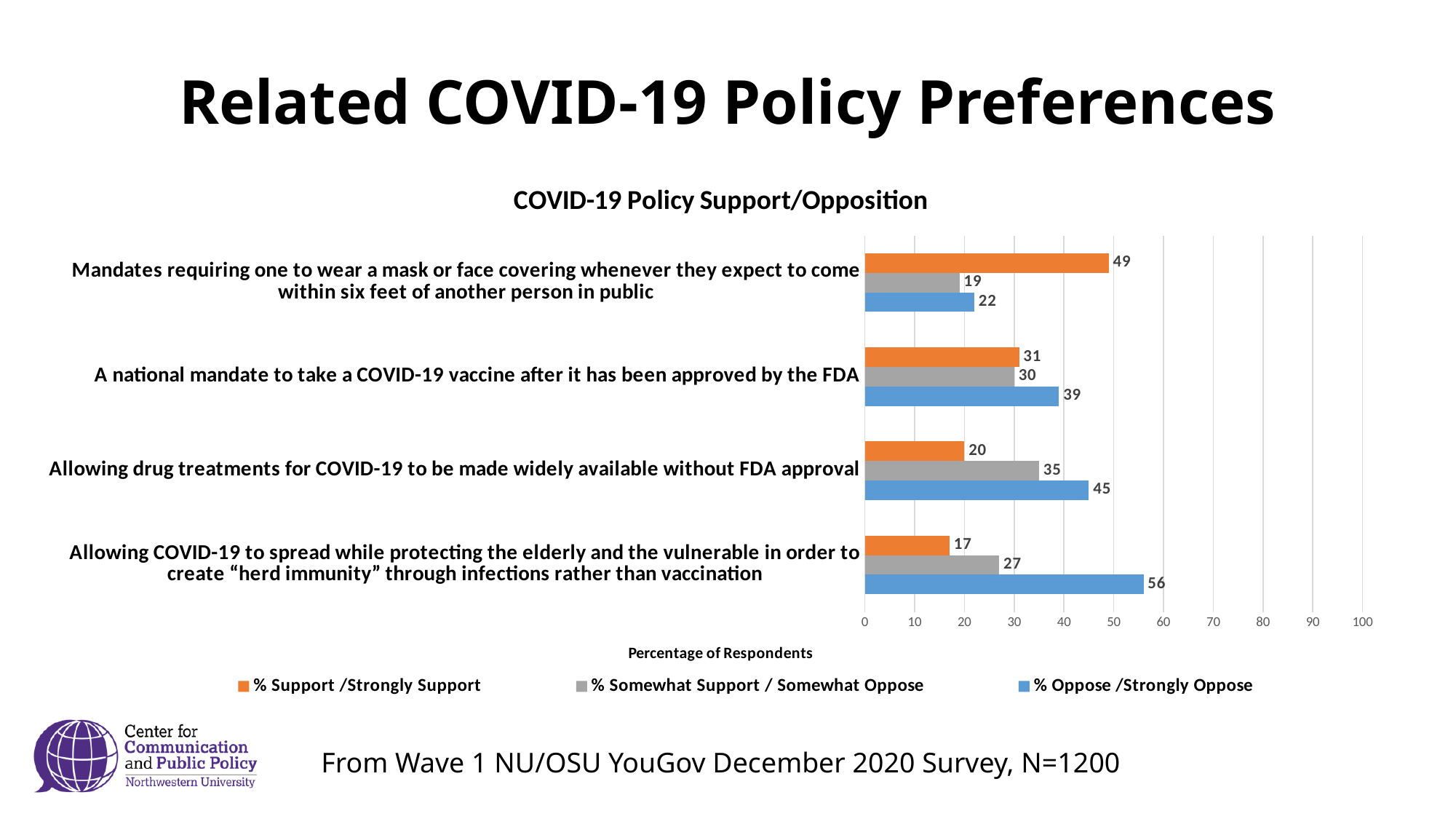
Which policy has the highest percentage of respondents who oppose or strongly oppose it? Allowing COVID-19 to spread while protecting the elderly and the vulnerable in order to create "herd immunity" through infections rather than vaccination What is the difference between the percentage who oppose/strongly oppose and the percentage who support/strongly support allowing COVID-19 to spread to create herd immunity? 39 What is the title of the chart? COVID-19 Policy Support/Opposition What percentage of respondents support or strongly support mandates requiring one to wear a mask or face covering whenever they expect to come within six feet of another person in public? 49 How many policies are shown on the chart? 4 What percentage of respondents somewhat support or somewhat oppose allowing drug treatments for COVID-19 to be made widely available without FDA approval? 35 Which policy has the lowest percentage of respondents who support or strongly support it? Allowing COVID-19 to spread while protecting the elderly and the vulnerable in order to create "herd immunity" through infections rather than vaccination How many series does the legend list? 3 What percentage of respondents oppose or strongly oppose a national mandate to take a COVID-19 vaccine after it has been approved by the FDA? 39 What kind of chart is shown on the slide? Bar chart For the mask mandate policy, which is larger: the percentage who support/strongly support or the percentage who oppose/strongly oppose? % Support /Strongly Support What colour represents the % Oppose /Strongly Oppose series? Blue